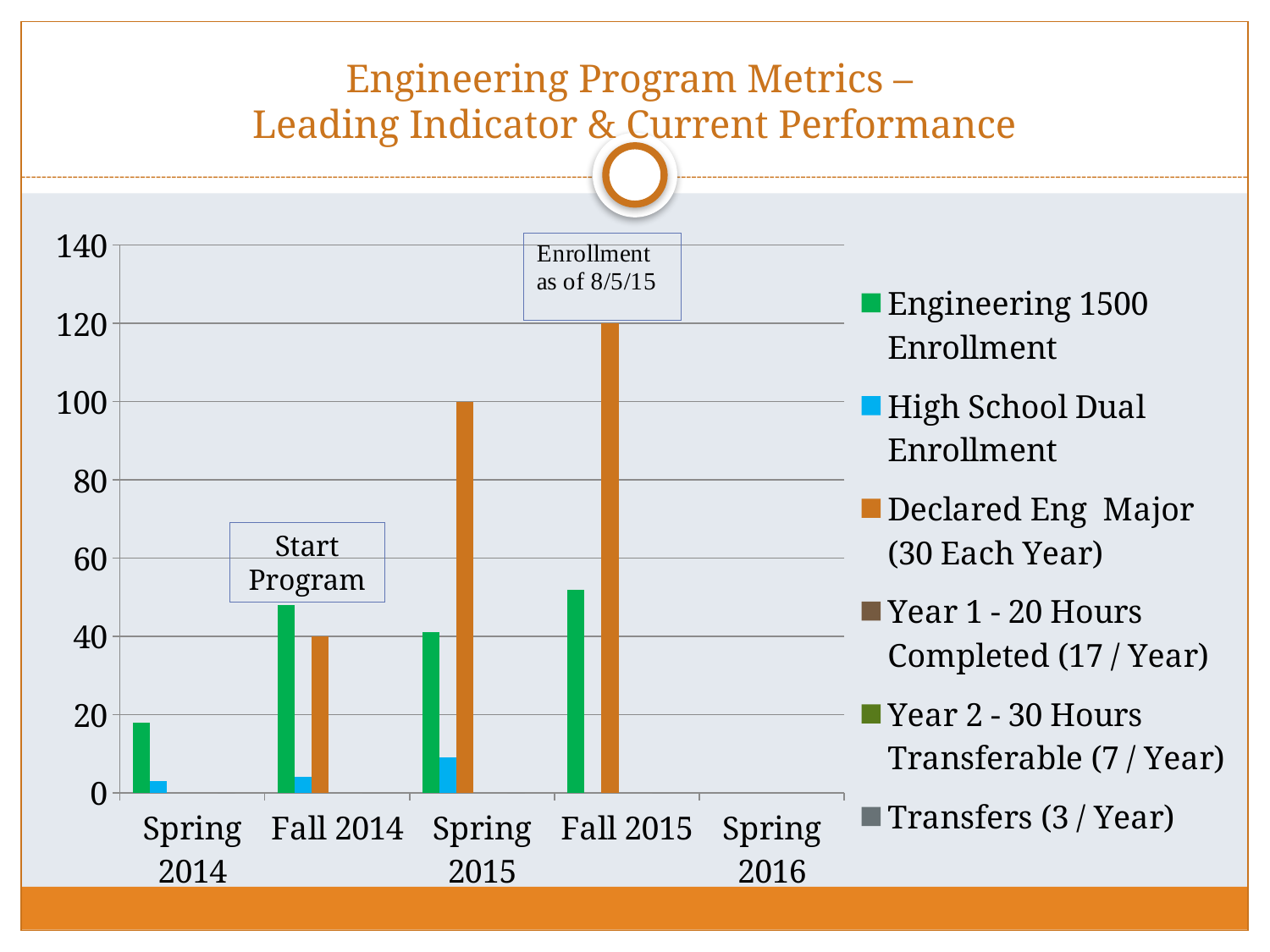
What is the value of Declared Eng Major (30 Each Year) for Fall 2014? 40 Is the Engineering 1500 Enrollment value for Fall 2015 greater or less than 40? greater Does the Declared Eng Major (30 Each Year) series rise or fall from Fall 2014 to Fall 2015? Rise What does the text box above the Fall 2014 bars say? Start Program What is the value of Declared Eng Major (30 Each Year) for Fall 2015? 120 What is the value of Declared Eng Major (30 Each Year) for Spring 2015? 100 How many series does the chart's legend list? 6 Is the Engineering 1500 Enrollment value for Spring 2014 greater or less than 20? less In which period is the Declared Eng Major (30 Each Year) bar highest? Fall 2015 By how much does Declared Eng Major (30 Each Year) in Fall 2015 exceed its value in Fall 2014? 80 What kind of chart is shown on the slide? Bar chart How many time periods are shown on the x axis of the chart? 5